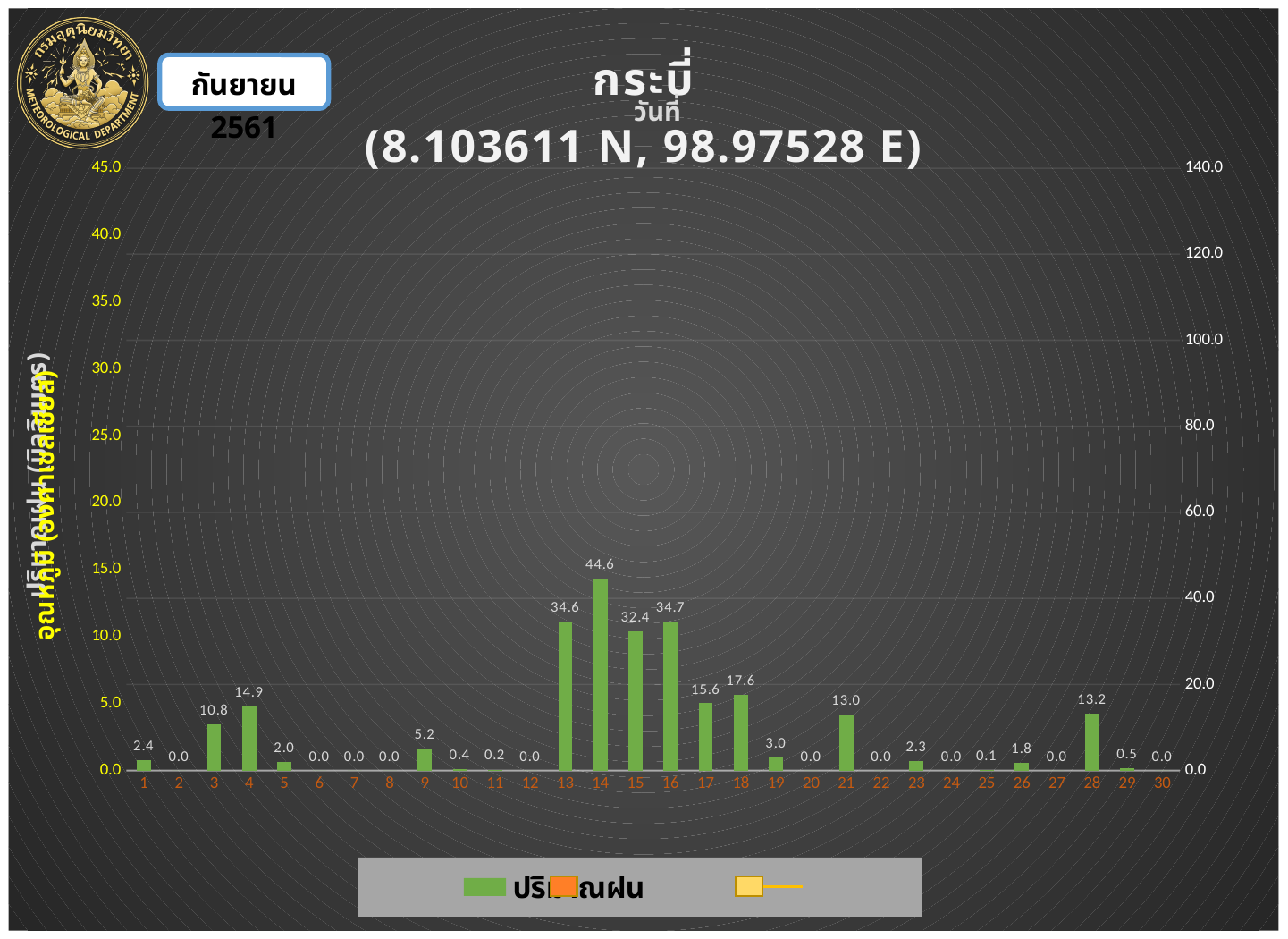
What is the difference between the values for day 14 and day 13? 10.0 What is the value of the bar for day 28? 13.2 What value is labelled on the bar for day 4? 14.9 How many days are shown on the x axis of the chart? 30 What value is labelled on the bar for day 25? 0.1 Which is larger, the value for day 3 or the value for day 21? day 21 What coordinates are given in the chart title? 8.103611 N, 98.97528 E Which is larger, the value for day 16 or the value for day 15? day 16 What is the rainfall value shown for day 14? 44.6 What is the difference between the values for day 18 and day 17? 2.0 Which day has the highest bar in the chart? 14 What type of chart is shown on the slide? bar chart